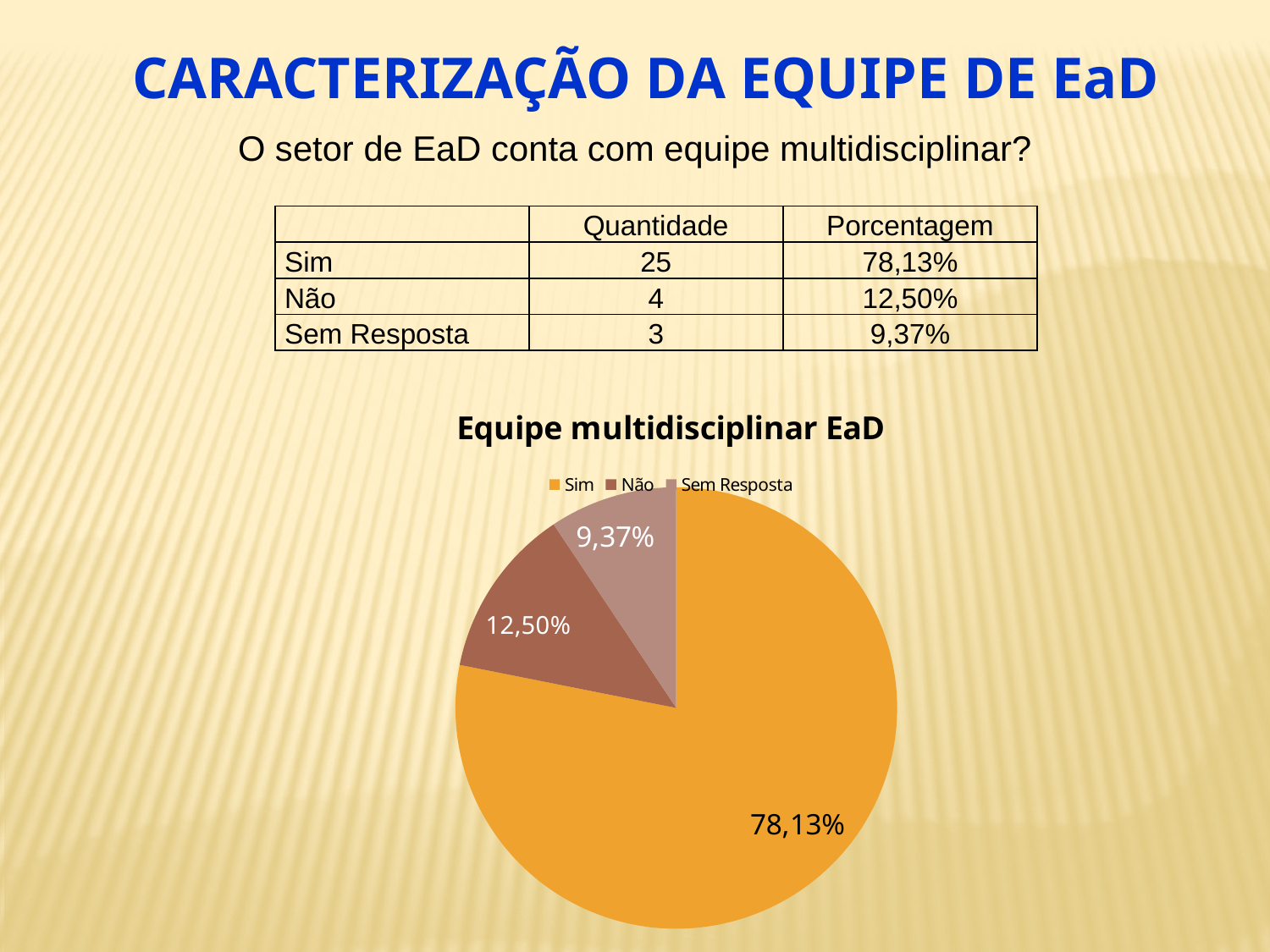
What kind of chart is shown on the slide? pie chart What percentage does the Sim slice show? 78,13% Which category has the smallest slice of the pie? Sem Resposta Which category has the largest slice of the pie? Sim How many slices does the pie chart have? 3 What percentage does the Sem Resposta slice show? 9,37% What is the difference in percentage points between the Sim slice and the Não slice? 65,63 What is the title of the chart? Equipe multidisciplinar EaD How many entries does the legend list? 3 What is the difference in percentage points between the Não slice and the Sem Resposta slice? 3,13 What percentage does the Não slice show? 12,50% Which is larger, the Não slice or the Sem Resposta slice? Não